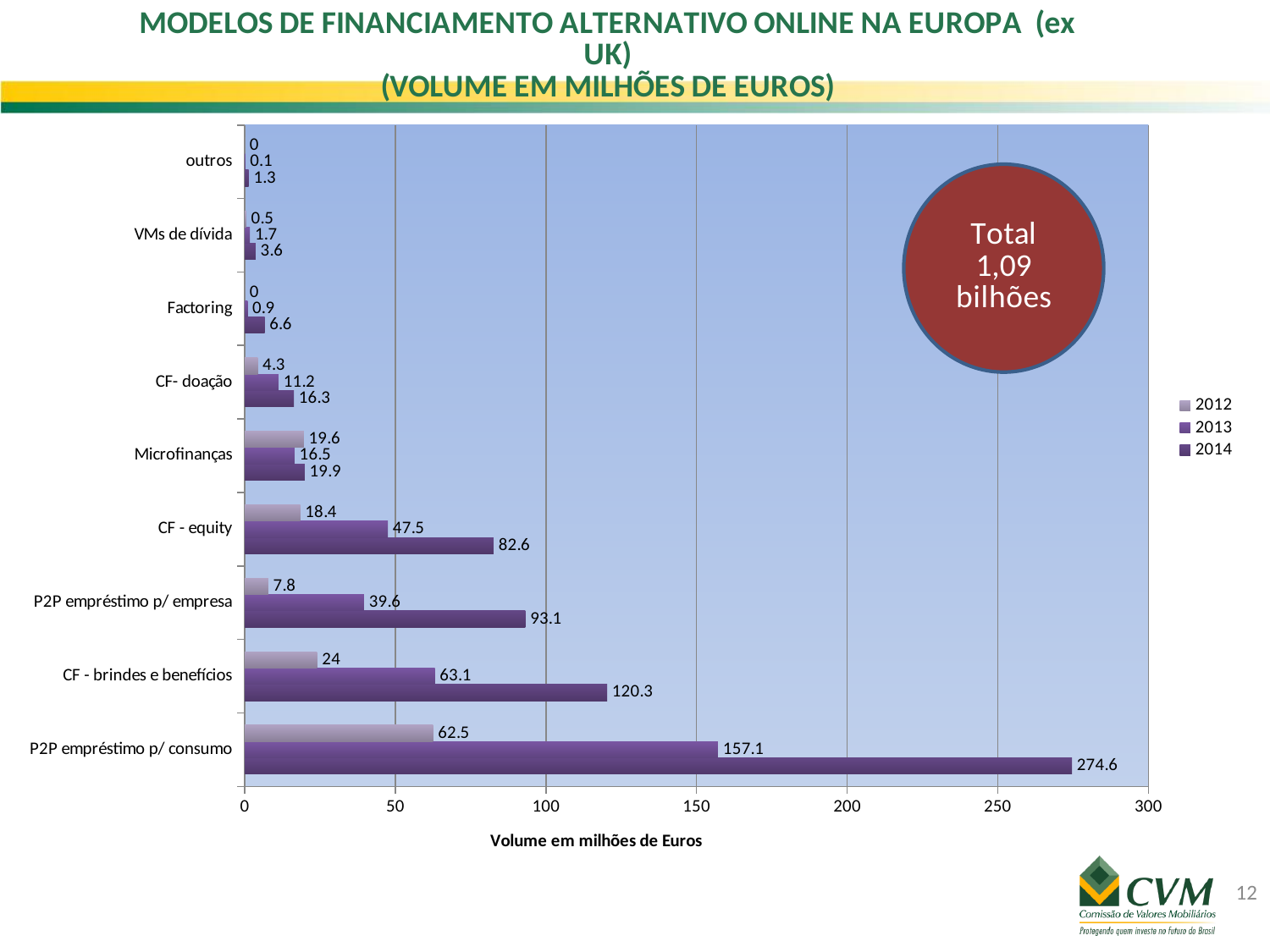
What kind of chart is shown on the slide? Bar chart What is the 2012 value for CF - equity? 18.4 Is the 2013 value for P2P empréstimo p/ consumo greater or less than 150? greater Which category has the highest 2014 value? P2P empréstimo p/ consumo What total is shown in the red circle on the chart? Total 1,09 bilhões Which is larger: the 2014 value for CF - equity or the 2014 value for P2P empréstimo p/ empresa? P2P empréstimo p/ empresa How many categories are shown on the chart? 9 What is the 2013 value for CF - brindes e benefícios? 63.1 Which category has the lowest 2014 value? outros What is the difference between the 2014 and 2013 values for P2P empréstimo p/ empresa? 53.5 How many series does the legend list? 3 What is the 2014 value for P2P empréstimo p/ consumo? 274.6